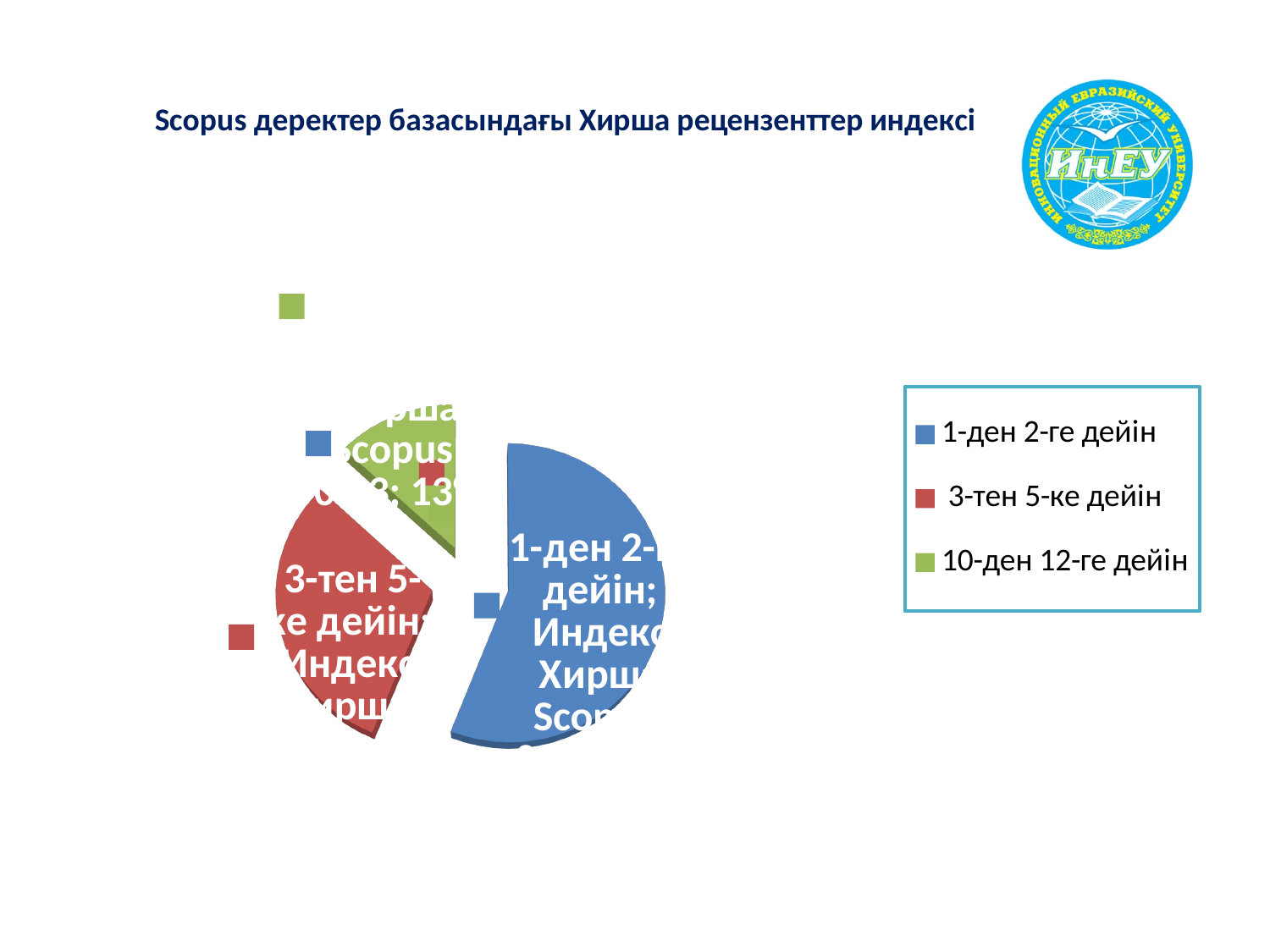
Which slice is larger: '1-ден 2-ге дейін' or '3-тен 5-ке дейін'? 1-ден 2-ге дейін What kind of chart is shown on the slide? pie chart How many slices does the pie chart have? 3 What is the title of the slide containing the pie chart? Scopus деректер базасындағы Хирша рецензенттер индексі What colour is the slice for '10-ден 12-ге дейін' in the pie chart? green How many entries does the legend of the pie chart list? 3 Which slice is larger: '3-тен 5-ке дейін' or '10-ден 12-ге дейін'? 3-тен 5-ке дейін Which category has the largest slice in the pie chart? 1-ден 2-ге дейін Which category has the smallest slice in the pie chart? 10-ден 12-ге дейін